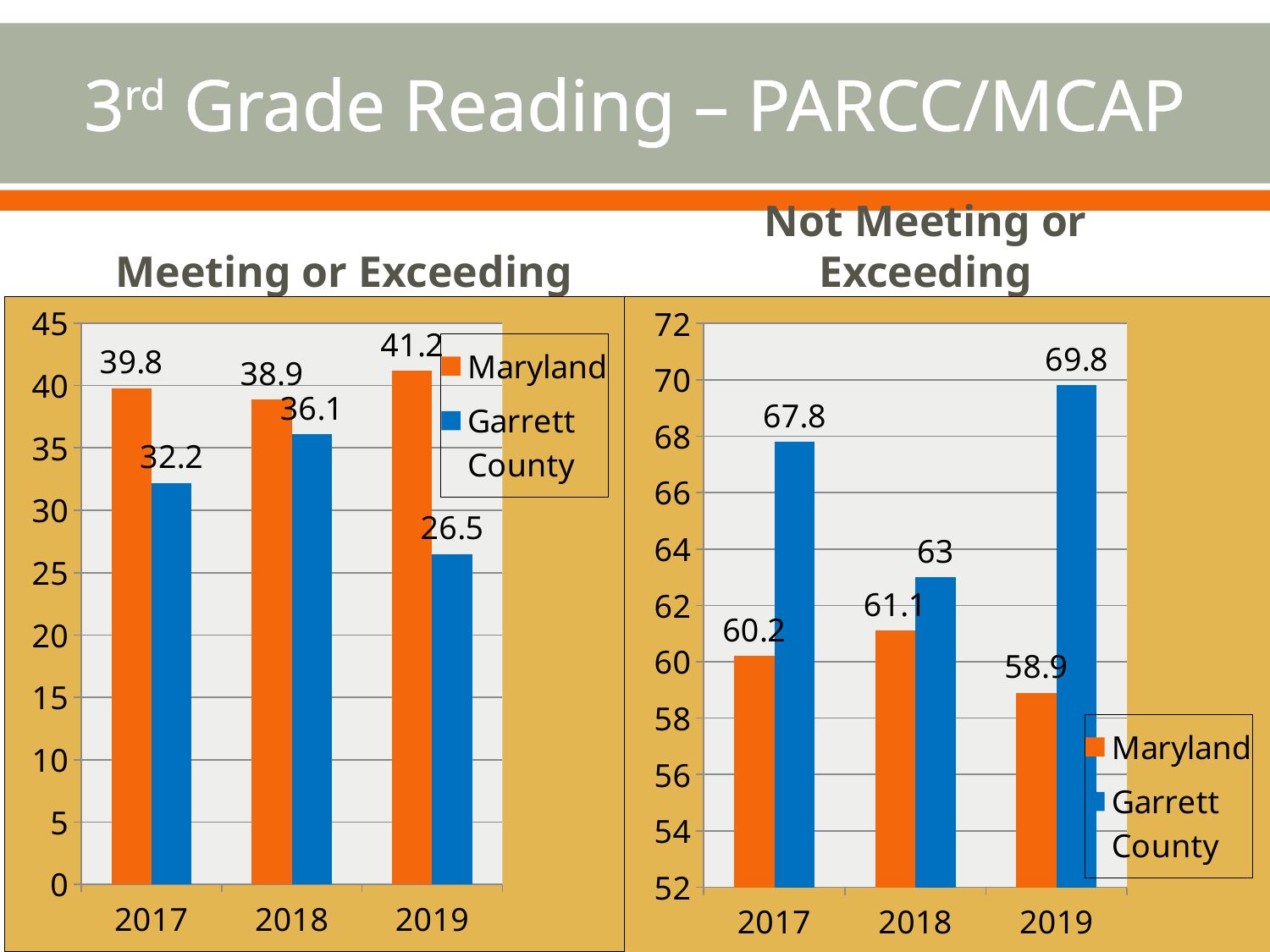
In the 'Not Meeting or Exceeding' chart, which year has the highest Garrett County value? 2019 In the 'Meeting or Exceeding' chart, what is the value for Garrett County in 2017? 32.2 In the 'Meeting or Exceeding' chart, which is larger in 2018: Maryland or Garrett County? Maryland In the 'Not Meeting or Exceeding' chart, what is the value for Garrett County in 2019? 69.8 In the 'Meeting or Exceeding' chart, what is the difference between the Maryland and Garrett County values in 2019? 14.7 In the 'Not Meeting or Exceeding' chart, what is the value for Maryland in 2018? 61.1 In the 'Not Meeting or Exceeding' chart, do the Maryland values rise or fall from 2018 to 2019? Fall In the 'Not Meeting or Exceeding' chart, what is the difference between the Garrett County and Maryland values in 2017? 7.6 What kind of chart is the 'Meeting or Exceeding' chart? Bar chart In the 'Meeting or Exceeding' chart, which year has the lowest Garrett County value? 2019 How many series does the legend of the 'Not Meeting or Exceeding' chart list? 2 In the 'Meeting or Exceeding' chart, what is the value for Maryland in 2019? 41.2